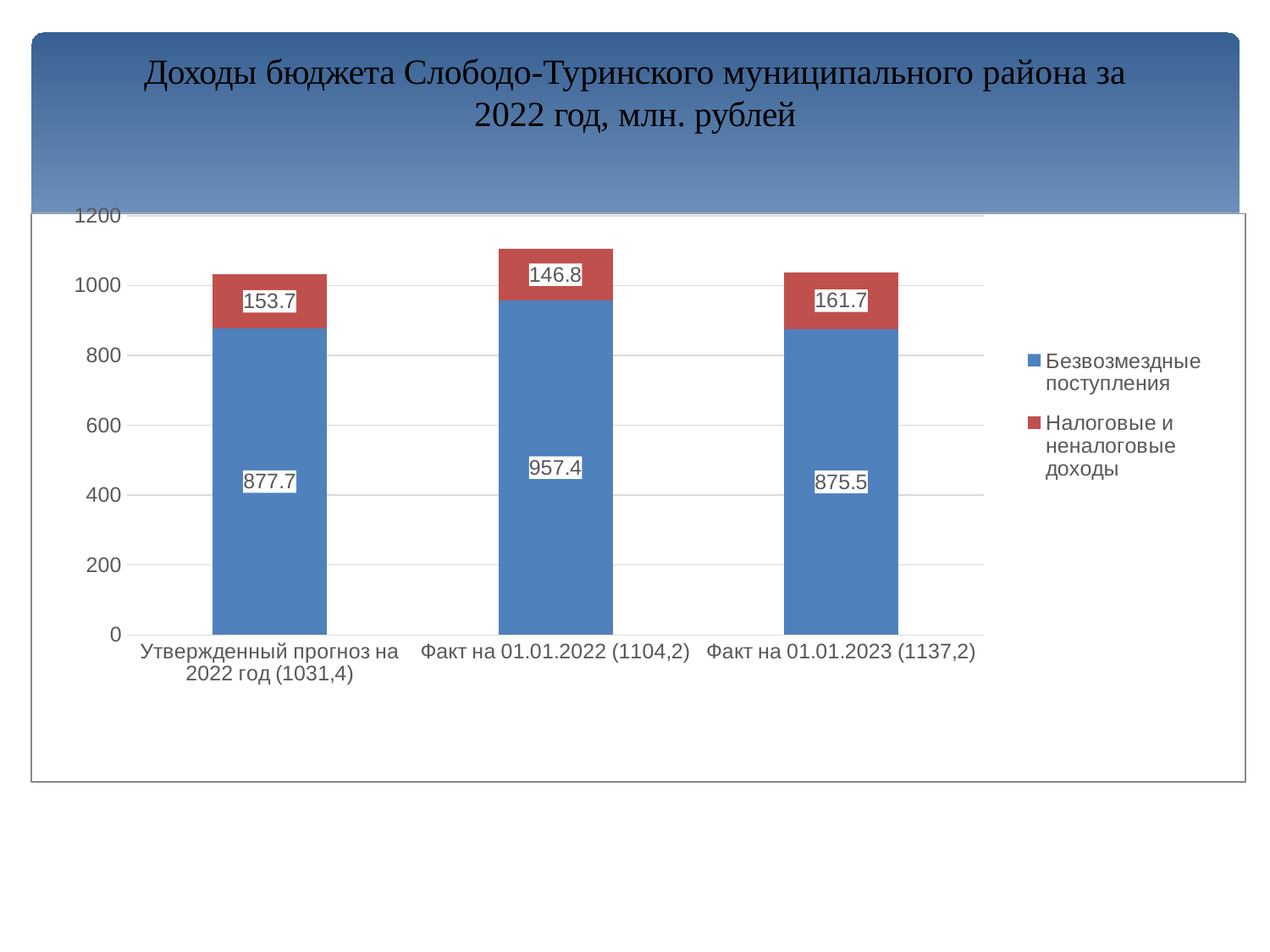
Which is larger: Налоговые и неналоговые доходы for Утвержденный прогноз на 2022 год (1031,4) or for Факт на 01.01.2023 (1137,2)? Факт на 01.01.2023 (1137,2) How many categories are shown on the x axis? 3 What is the value of Налоговые и неналоговые доходы for Утвержденный прогноз на 2022 год (1031,4)? 153.7 What type of chart is shown on the slide? Stacked bar chart Which category has the lowest value for Налоговые и неналоговые доходы? Факт на 01.01.2022 (1104,2) What is the title of the chart? Доходы бюджета Слободо-Туринского муниципального района за 2022 год, млн. рублей What is the value of Безвозмездные поступления for Факт на 01.01.2022 (1104,2)? 957.4 What is the value of Налоговые и неналоговые доходы for Факт на 01.01.2023 (1137,2)? 161.7 What is the difference between Безвозмездные поступления for Факт на 01.01.2022 (1104,2) and for Факт на 01.01.2023 (1137,2)? 81.9 Which category has the highest value for Безвозмездные поступления? Факт на 01.01.2022 (1104,2) What is the total of the stacked bar for Факт на 01.01.2022 (1104,2)? 1104.2 How many series does the legend list? 2